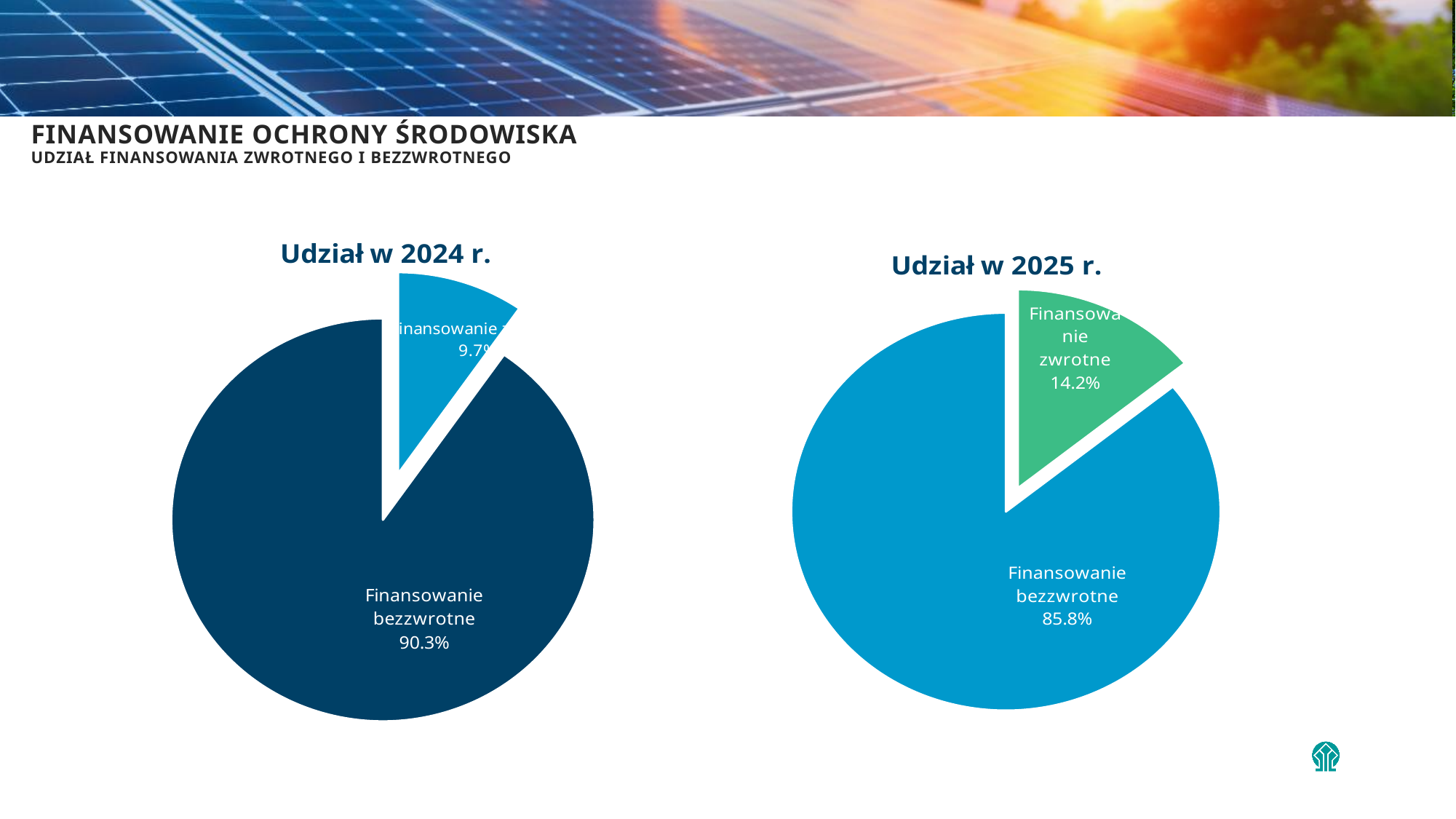
How many slices does the "Udział w 2025 r." pie chart have? 2 Which is larger: the share of Finansowanie bezzwrotne in the 2024 chart or in the 2025 chart? 2024 chart In the "Udział w 2025 r." chart, what share does Finansowanie bezzwrotne have? 85.8% In the "Udział w 2024 r." chart, what share does Finansowanie bezzwrotne have? 90.3% What kind of chart is shown under the title "Udział w 2024 r."? pie chart In the "Udział w 2025 r." chart, what share does Finansowanie zwrotne have? 14.2% How many pie charts are shown on the slide? 2 In the "Udział w 2025 r." chart, which category has the largest share? Finansowanie bezzwrotne In the "Udział w 2025 r." chart, what is the difference in percentage points between Finansowanie bezzwrotne and Finansowanie zwrotne? 71.6 In the "Udział w 2025 r." chart, which category has the smallest share? Finansowanie zwrotne What colour is the Finansowanie zwrotne slice in the "Udział w 2025 r." chart? green